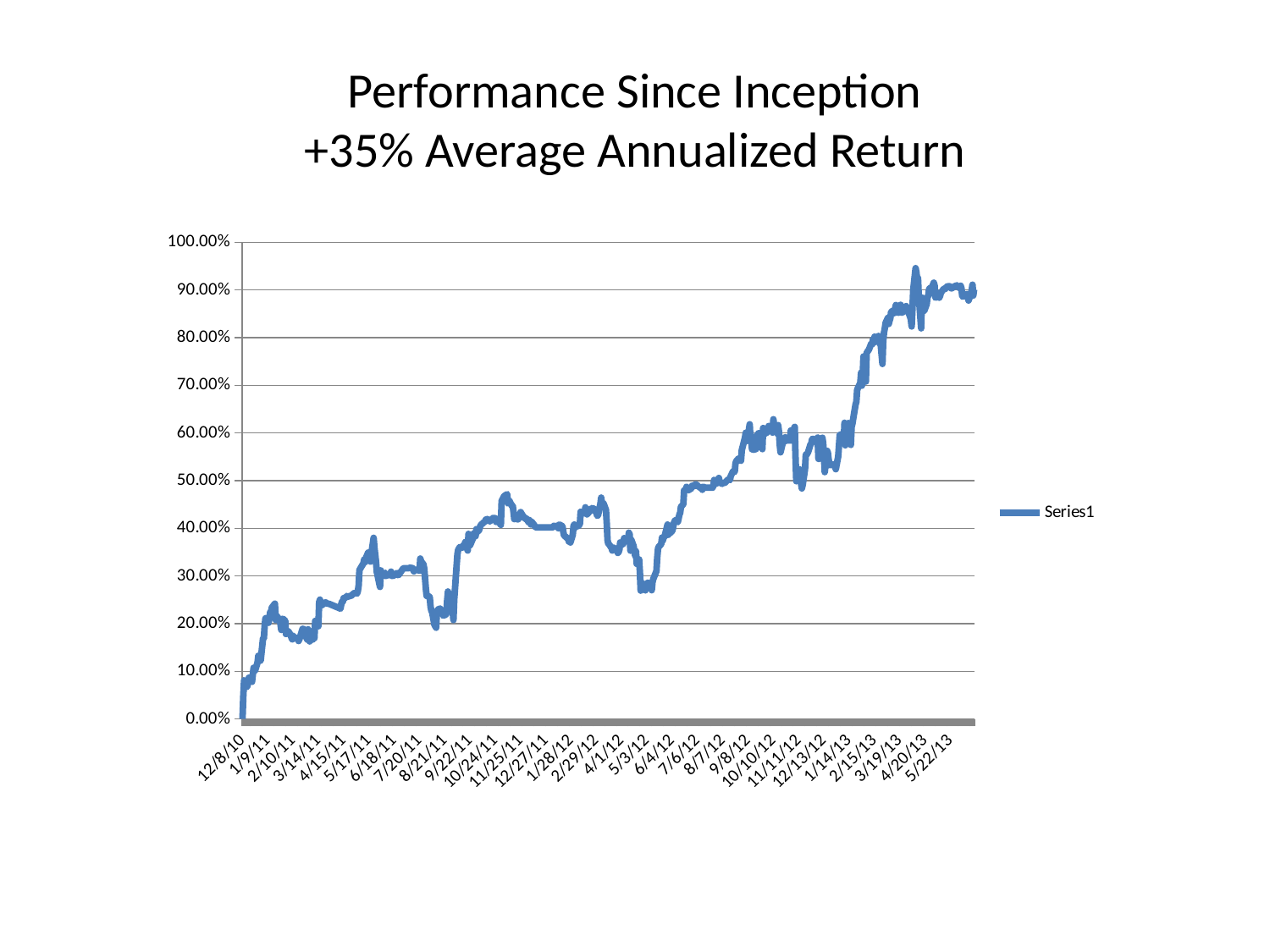
How many series does the legend list? 1 Is the value at 12/27/11 greater or less than 50.00%? less Is the value at 3/19/13 greater or less than 80.00%? greater Is the value at 5/22/13 greater or less than 80.00%? greater What is the title of the chart on the slide? Performance Since Inception +35% Average Annualized Return Overall, do the values rise or fall from 12/8/10 to 5/22/13? rise Which is larger, the value at 5/22/13 or the value at 12/8/10? 5/22/13 What kind of chart is shown on the slide? line chart What is the name of the series shown in the legend? Series1